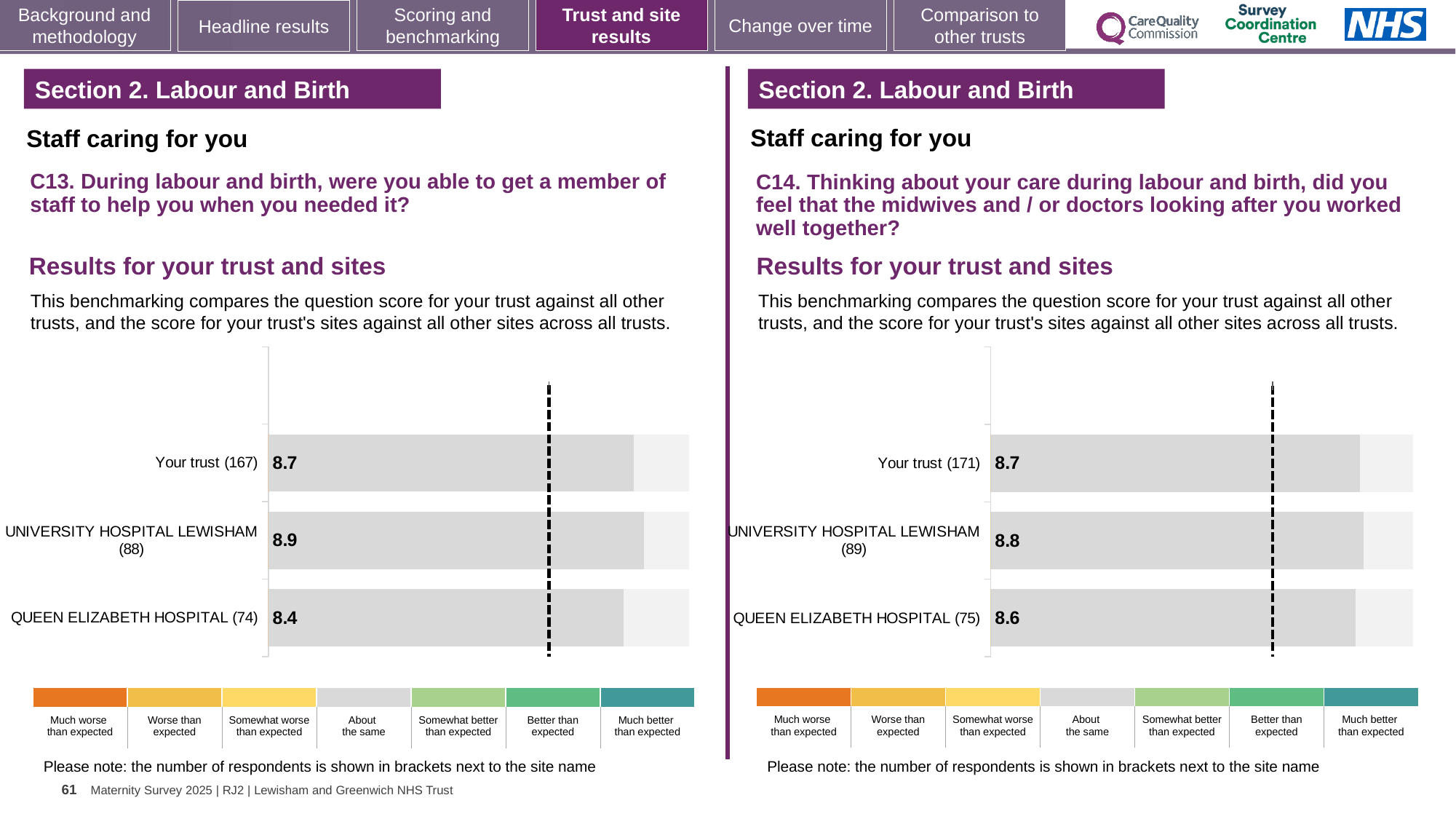
What kind of chart is the C13 chart (left)? Bar chart On the C14 chart (right), what is the score for UNIVERSITY HOSPITAL LEWISHAM (89)? 8.8 On the C13 chart (left), what is the score for Your trust (167)? 8.7 On the C13 chart (left), which site or trust has the highest score? UNIVERSITY HOSPITAL LEWISHAM (88) On the C14 chart (right), what is the score for QUEEN ELIZABETH HOSPITAL (75)? 8.6 How many bars are plotted on the C14 chart (right)? 3 On the C13 chart (left), which site or trust has the lowest score? QUEEN ELIZABETH HOSPITAL (74) On the C14 chart (right), what is the score for Your trust (171)? 8.7 On the C13 chart (left), what is the score for QUEEN ELIZABETH HOSPITAL (74)? 8.4 On the C13 chart (left), what is the score for UNIVERSITY HOSPITAL LEWISHAM (88)? 8.9 On the C14 chart (right), which site or trust has the lowest score? QUEEN ELIZABETH HOSPITAL (75) On the C13 chart (left), what is the difference between the scores for UNIVERSITY HOSPITAL LEWISHAM (88) and QUEEN ELIZABETH HOSPITAL (74)? 0.5